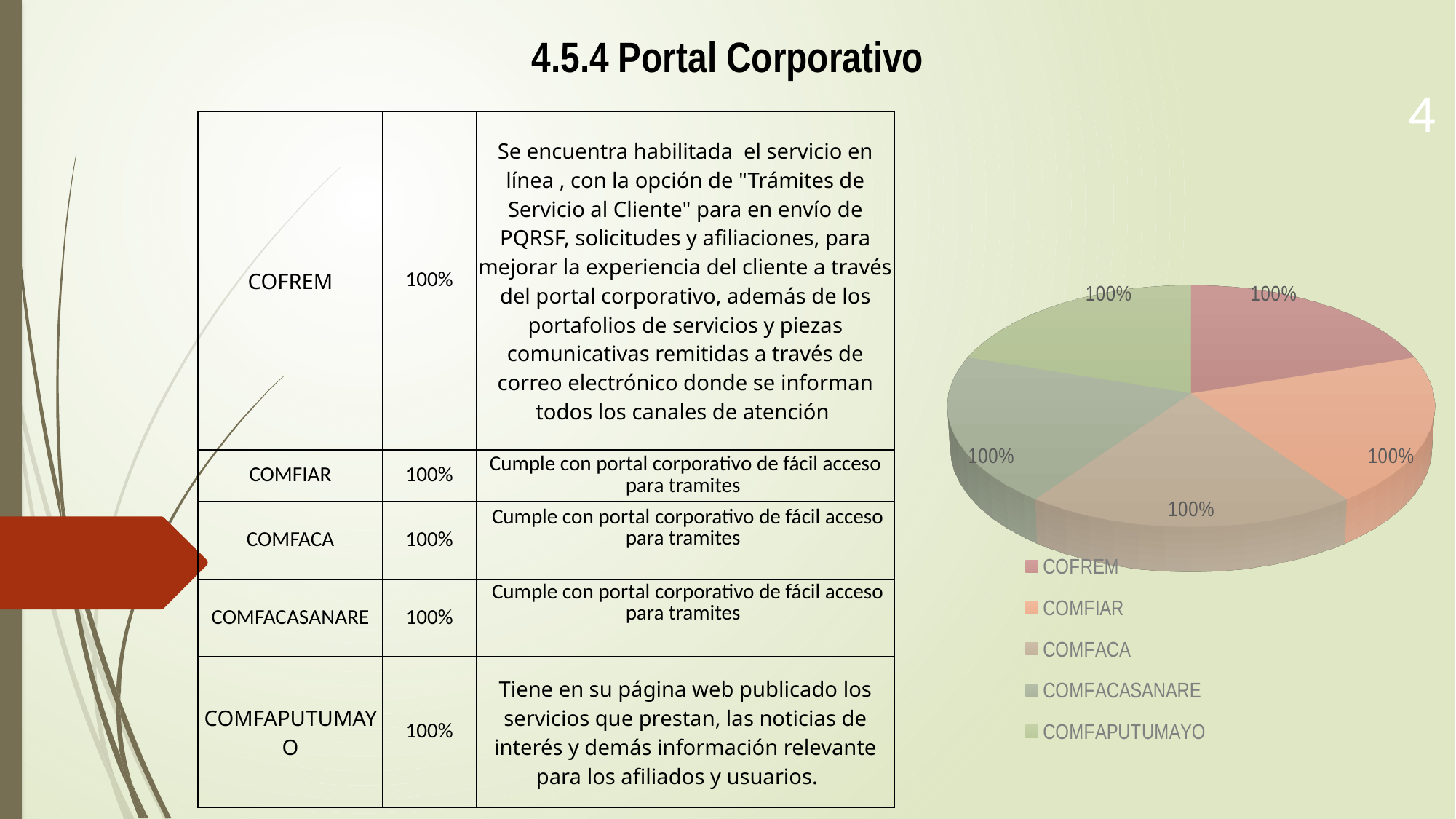
What value is labelled on the COMFACASANARE slice of the pie chart? 100% What value is labelled on the COMFIAR slice of the pie chart? 100% What value is labelled on the COFREM slice of the pie chart? 100% How many entries does the pie chart's legend list? 5 Which legend entry is listed first in the pie chart's legend? COFREM What value is labelled on the COMFAPUTUMAYO slice of the pie chart? 100% How many slices does the pie chart have? 5 Which legend entry is listed last in the pie chart's legend? COMFAPUTUMAYO What kind of chart is shown on the right side of the slide? pie chart What is the difference between the labelled values for COMFACA and COMFIAR in the pie chart? 0%